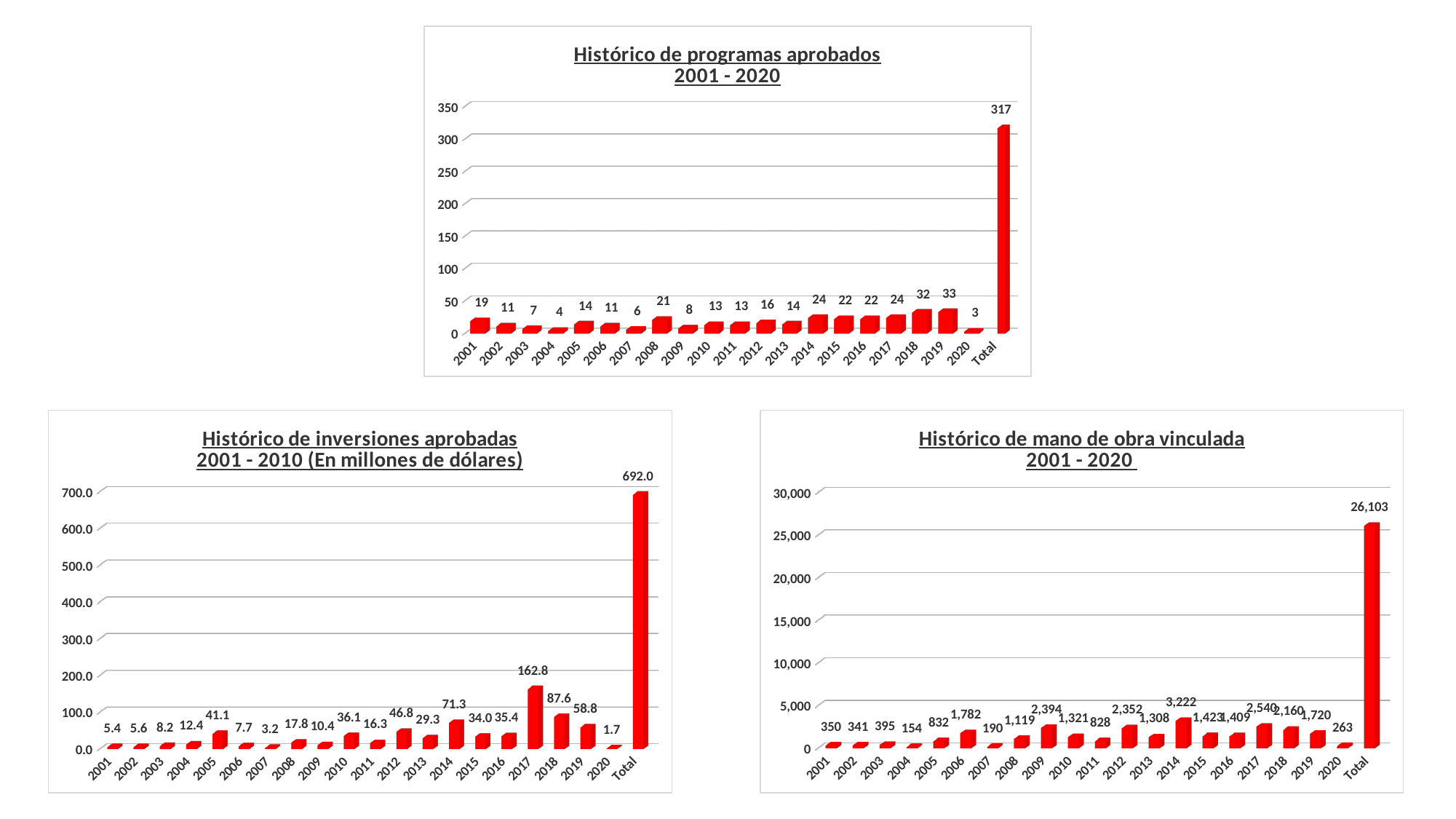
In the chart 'Histórico de inversiones aprobadas 2001 - 2010 (En millones de dólares)', what is the value for 2017? 162.8 In the chart 'Histórico de mano de obra vinculada 2001 - 2020', which year has the lowest value? 2004 In the chart 'Histórico de programas aprobados 2001 - 2020', which year has the lowest value? 2020 In the chart 'Histórico de programas aprobados 2001 - 2020', what is the difference between the values for 2018 and 2004? 28 In the chart 'Histórico de inversiones aprobadas 2001 - 2010 (En millones de dólares)', what is the value of the Total bar? 692.0 In the chart 'Histórico de inversiones aprobadas 2001 - 2010 (En millones de dólares)', which is larger, the value for 2014 or the value for 2018? 2018 What kind of chart is 'Histórico de mano de obra vinculada 2001 - 2020'? Bar chart In the chart 'Histórico de programas aprobados 2001 - 2020', what is the value of the Total bar? 317 In the chart 'Histórico de inversiones aprobadas 2001 - 2010 (En millones de dólares)', which year has the highest value (excluding Total)? 2017 In the chart 'Histórico de programas aprobados 2001 - 2020', what is the value for 2019? 33 In the chart 'Histórico de mano de obra vinculada 2001 - 2020', what is the difference between the values for 2009 and 2010? 1,073 In the chart 'Histórico de mano de obra vinculada 2001 - 2020', what is the value for 2014? 3,222